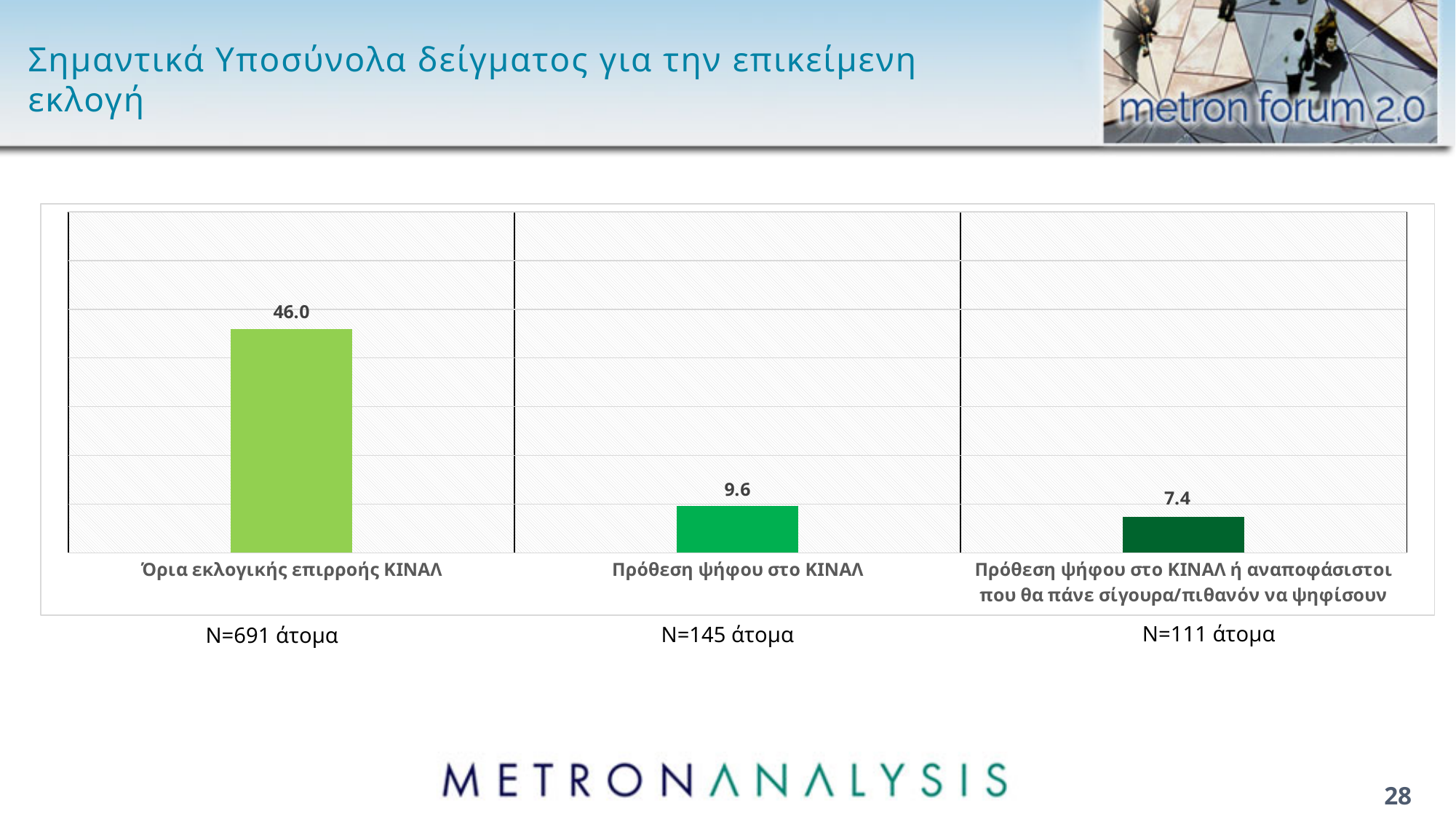
What is the difference between the values for Πρόθεση ψήφου στο ΚΙΝΑΛ and Πρόθεση ψήφου στο ΚΙΝΑΛ ή αναποφάσιστοι που θα πάνε σίγουρα/πιθανόν να ψηφίσουν? 2.2 What sample size (N) is shown under the Πρόθεση ψήφου στο ΚΙΝΑΛ bar? N=145 άτομα Do the values rise or fall from left to right across the categories? Fall What is the value for Όρια εκλογικής επιρροής ΚΙΝΑΛ? 46.0 Which category has the lowest value? Πρόθεση ψήφου στο ΚΙΝΑΛ ή αναποφάσιστοι που θα πάνε σίγουρα/πιθανόν να ψηφίσουν Which category has the highest value? Όρια εκλογικής επιρροής ΚΙΝΑΛ What is the value for Πρόθεση ψήφου στο ΚΙΝΑΛ ή αναποφάσιστοι που θα πάνε σίγουρα/πιθανόν να ψηφίσουν? 7.4 How many categories are shown in the chart? 3 What is the value for Πρόθεση ψήφου στο ΚΙΝΑΛ? 9.6 What is the difference between the values for Όρια εκλογικής επιρροής ΚΙΝΑΛ and Πρόθεση ψήφου στο ΚΙΝΑΛ? 36.4 What kind of chart is shown on the slide? Bar chart Which is larger: the value for Πρόθεση ψήφου στο ΚΙΝΑΛ or the value for Πρόθεση ψήφου στο ΚΙΝΑΛ ή αναποφάσιστοι που θα πάνε σίγουρα/πιθανόν να ψηφίσουν? Πρόθεση ψήφου στο ΚΙΝΑΛ